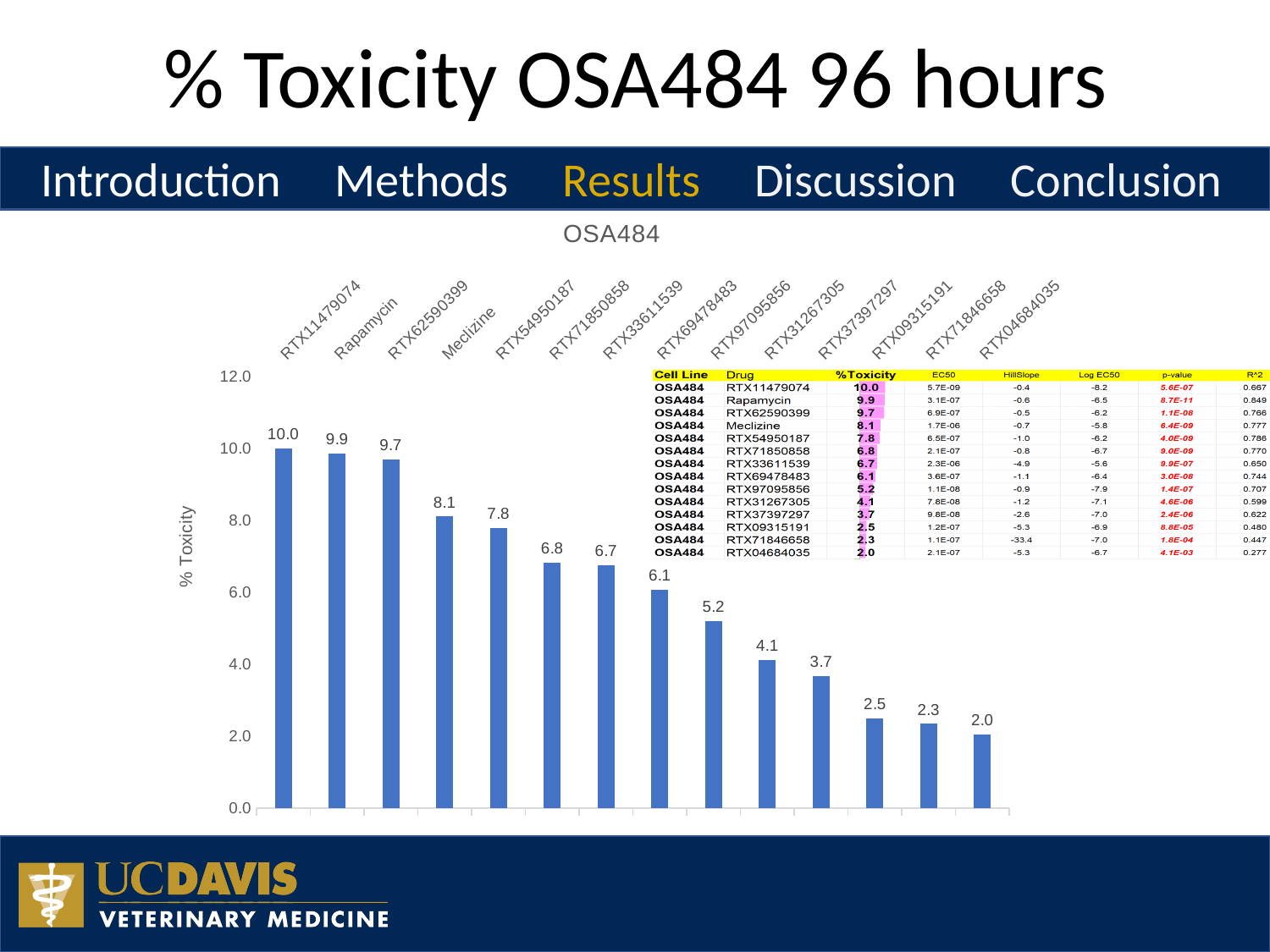
Do the % Toxicity values rise or fall from left to right along the x axis? fall What is the difference in % Toxicity between RTX11479074 and RTX04684035? 8.0 What is the difference in % Toxicity between Meclizine and RTX54950187? 0.3 What is the % Toxicity value for Rapamycin? 9.9 What is the % Toxicity value for RTX97095856? 5.2 How many drugs are plotted in the bar chart? 14 Which has a higher % Toxicity, RTX31267305 or RTX37397297? RTX31267305 Which drug has the lowest % Toxicity in the chart? RTX04684035 Which drug has the highest % Toxicity in the chart? RTX11479074 What is the % Toxicity value for Meclizine? 8.1 Is the % Toxicity value for RTX69478483 greater or less than 8.0? less What type of chart is shown on the slide? bar chart